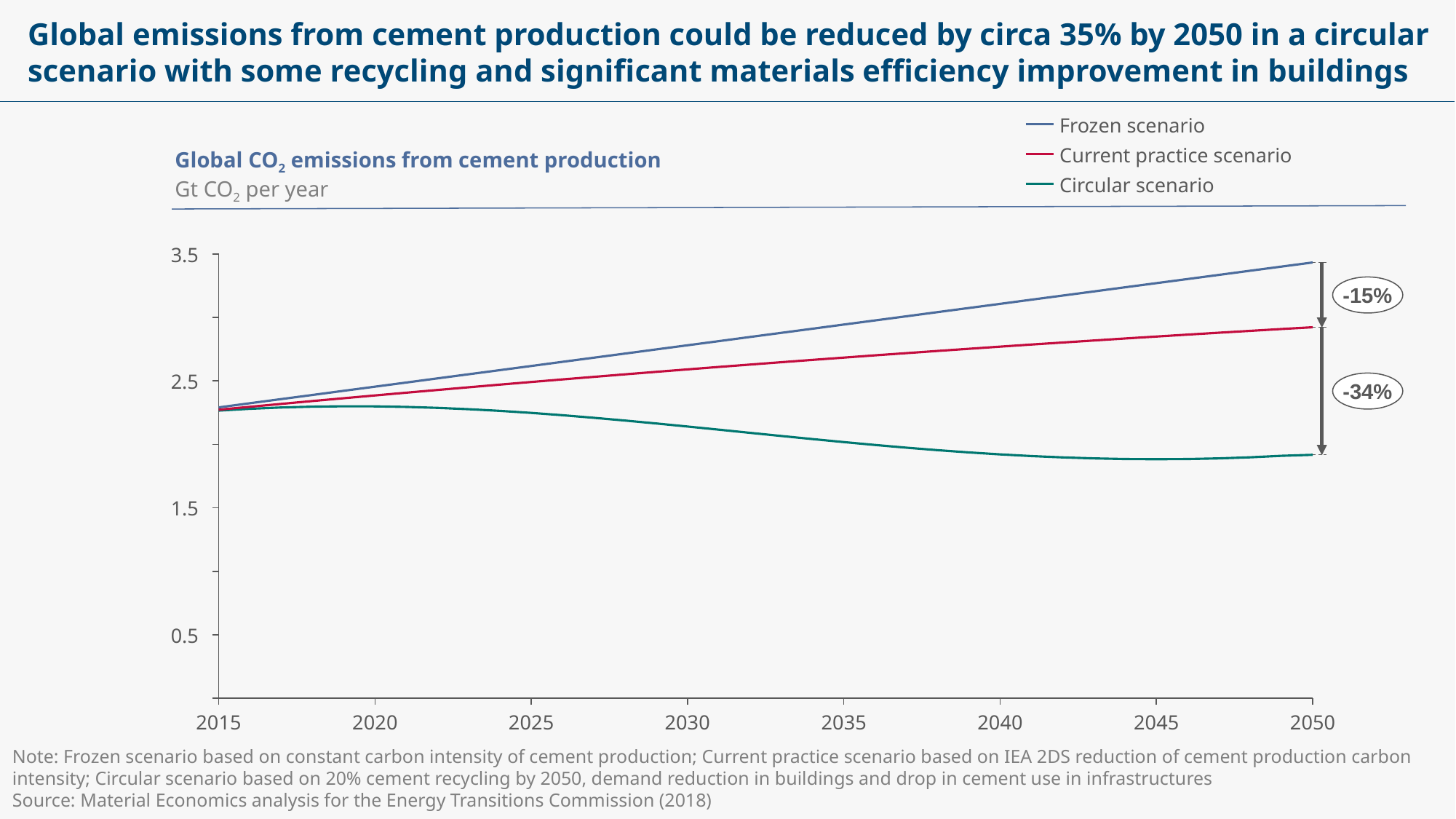
Is the value for the Circular scenario in 2050 greater or less than 1.5? greater In 2050, which is larger: the Current practice scenario or the Circular scenario? Current practice scenario How many series does the legend list? 3 What percentage reduction is annotated between the Frozen scenario and the Current practice scenario in 2050? -15% What kind of chart is shown on the slide? Line chart Which scenario has the lowest emissions in 2050? Circular scenario What percentage reduction is annotated between the Current practice scenario and the Circular scenario in 2050? -34% What unit is the chart's y axis measured in? Gt CO2 per year Which scenario has the highest emissions in 2050? Frozen scenario Do the values for the Frozen scenario rise or fall from 2015 to 2050? Rise Is the value for the Circular scenario in 2050 greater or less than 2.5? less Is the value for the Frozen scenario in 2050 greater or less than 2.5? greater